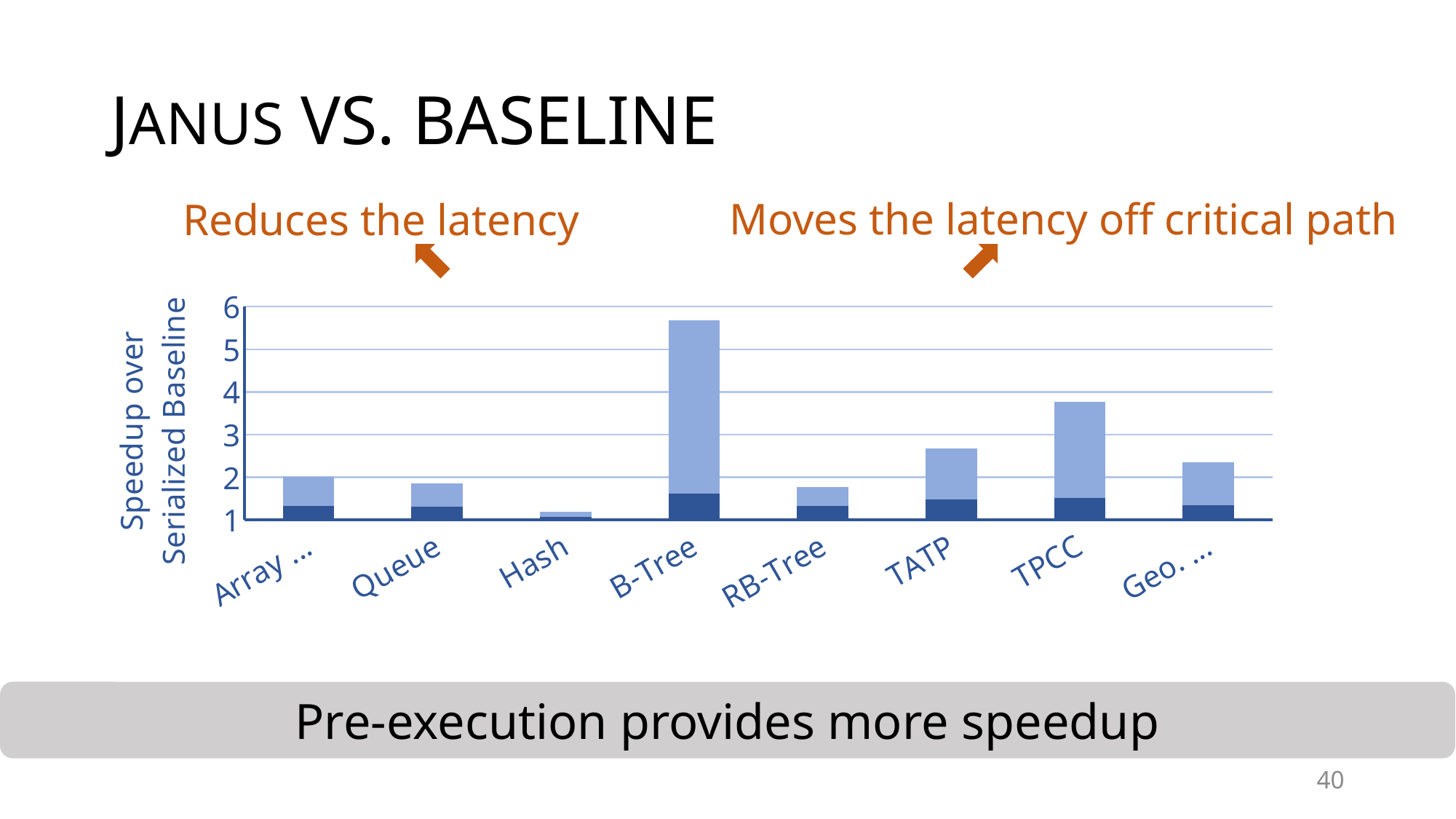
Which category has the highest total speedup in the chart? B-Tree Is the total value for Hash greater or less than 2? less Is the total value for TPCC greater or less than 3? greater Which has a larger total speedup, TPCC or TATP? TPCC What is the label on the y axis of the chart? Speedup over Serialized Baseline Is the total value for B-Tree greater or less than 5? greater What kind of chart is shown on the slide? Stacked bar chart Which has a larger total speedup, Queue or B-Tree? B-Tree Which category has the lowest total speedup in the chart? Hash How many categories are shown along the x axis of the chart? 8